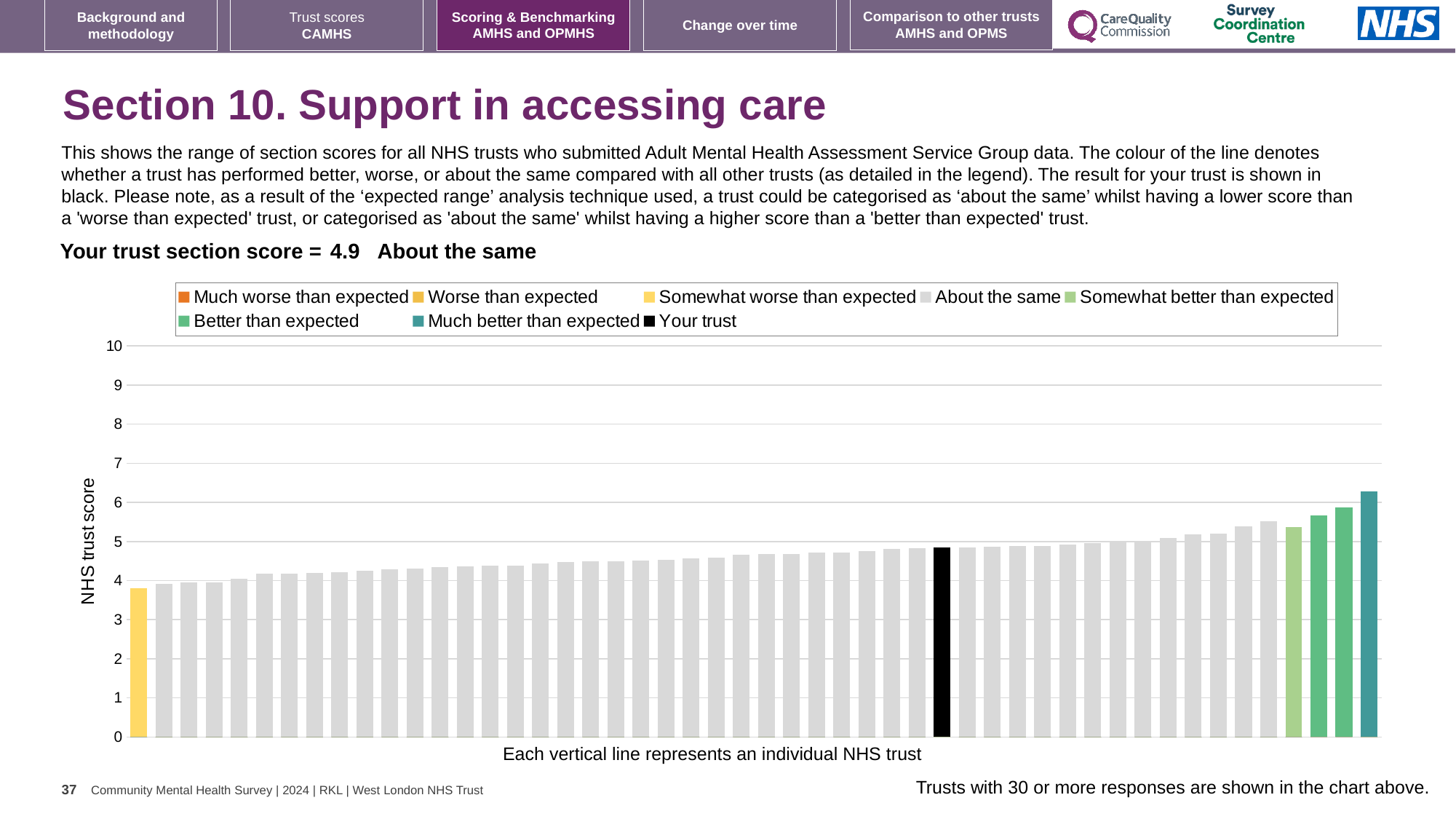
What kind of chart is shown on the slide? bar chart What colour is used for the 'Your trust' bar in the chart? black What is the section score for your trust? 4.9 Do the bar values rise or fall from left to right along the x axis? rise Which category is your trust placed in for this section? About the same Is the value of the tallest bar (Much better than expected) greater or less than 5? greater Is the value of the black 'Your trust' bar greater or less than 4? greater Which legend category does the lowest bar belong to? Somewhat worse than expected Which legend category does the highest bar belong to? Much better than expected What is the label on the y axis of the chart? NHS trust score How many entries does the chart legend list? 8